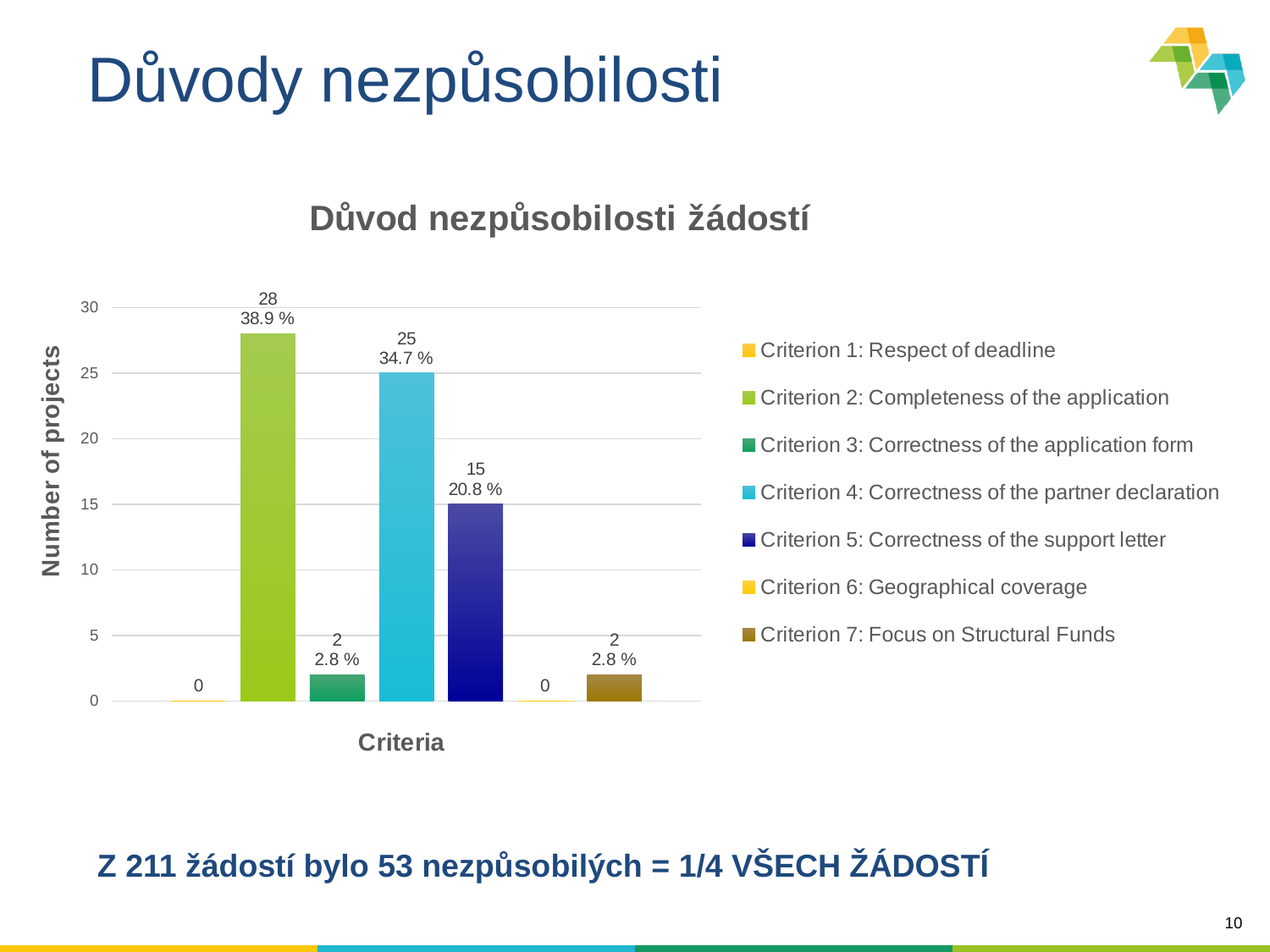
What is the difference in number of projects between Criterion 2 and Criterion 4? 3 What percentage is shown on the bar for Criterion 5: Correctness of the support letter? 20.8 % What is the title of the chart? Důvod nezpůsobilosti žádostí What is the difference in number of projects between Criterion 4 and Criterion 5? 10 What is the label of the vertical axis of the chart? Number of projects How many series does the legend list? 7 What kind of chart is shown on the slide? Bar chart What is the number of projects for Criterion 2: Completeness of the application? 28 Which criterion has the highest number of projects? Criterion 2: Completeness of the application What is the number of projects for Criterion 4: Correctness of the partner declaration? 25 What is the number of projects for Criterion 7: Focus on Structural Funds? 2 Which has more projects, Criterion 5: Correctness of the support letter or Criterion 3: Correctness of the application form? Criterion 5: Correctness of the support letter